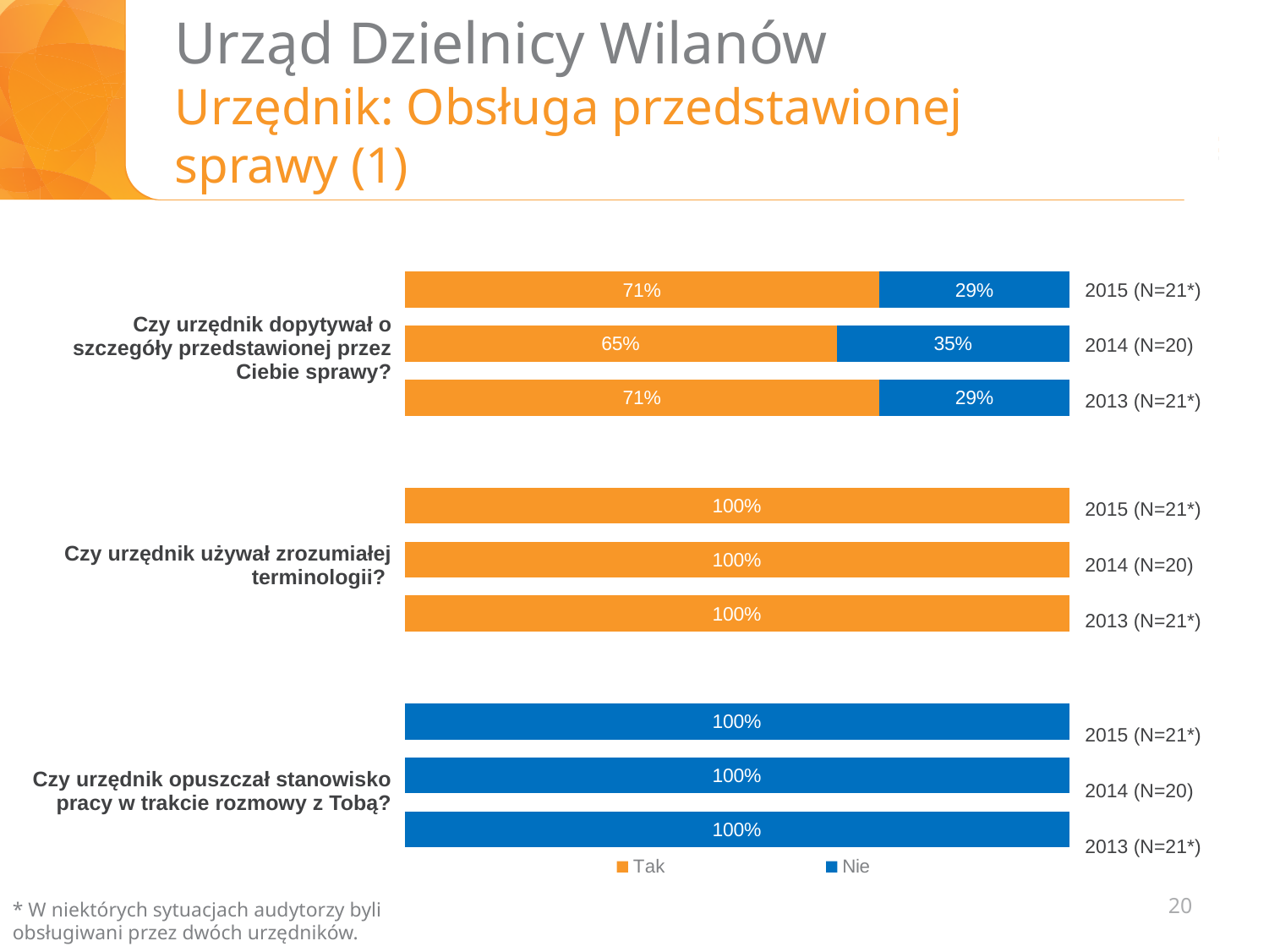
What share answered "Tak" to "Czy urzędnik używał zrozumiałej terminologii?" in 2014 (N=20)? 100% For "Czy urzędnik dopytywał o szczegóły przedstawionej przez Ciebie sprawy?", which year has the lowest "Tak" share? 2014 (N=20) What share answered "Nie" to "Czy urzędnik opuszczał stanowisko pracy w trakcie rozmowy z Tobą?" in 2015 (N=21*)? 100% How many years are shown for each question in the chart? 3 What are the two series named in the legend? Tak and Nie What share answered "Tak" to "Czy urzędnik dopytywał o szczegóły przedstawionej przez Ciebie sprawy?" in 2013 (N=21*)? 71% What share answered "Tak" to "Czy urzędnik dopytywał o szczegóły przedstawionej przez Ciebie sprawy?" in 2015 (N=21*)? 71% For "Czy urzędnik dopytywał o szczegóły przedstawionej przez Ciebie sprawy?" in 2014 (N=20), which is larger, the "Tak" share or the "Nie" share? Tak How many series does the legend list? 2 What share answered "Nie" to "Czy urzędnik dopytywał o szczegóły przedstawionej przez Ciebie sprawy?" in 2014 (N=20)? 35% For "Czy urzędnik dopytywał o szczegóły przedstawionej przez Ciebie sprawy?", what is the difference between the "Tak" share in 2015 and in 2014? 6 percentage points What kind of chart is shown on the slide? stacked bar chart